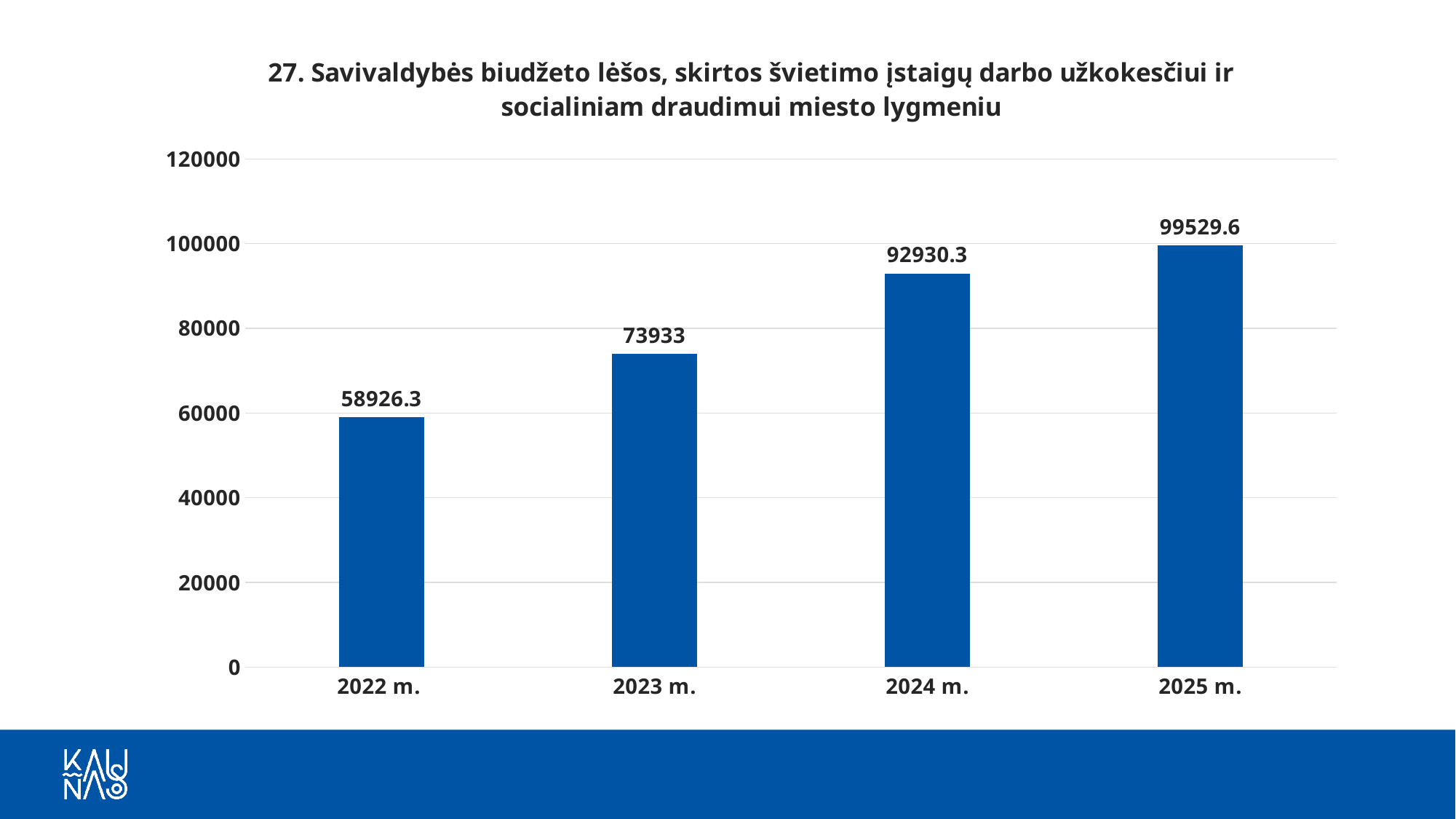
What is the value for 2024 m.? 92930.3 Which is larger, the value for 2023 m. or the value for 2024 m.? 2024 m. What is the difference between the values for 2025 m. and 2024 m.? 6599.3 Which year has the lowest value? 2022 m. Which year has the highest value? 2025 m. What is the difference between the values for 2023 m. and 2022 m.? 15006.7 Is the value for 2025 m. greater or less than 100000? less What is the value for 2022 m.? 58926.3 What is the value for 2025 m.? 99529.6 What kind of chart is shown on the slide? Bar chart What is the value for 2023 m.? 73933 How many years are shown on the x axis? 4